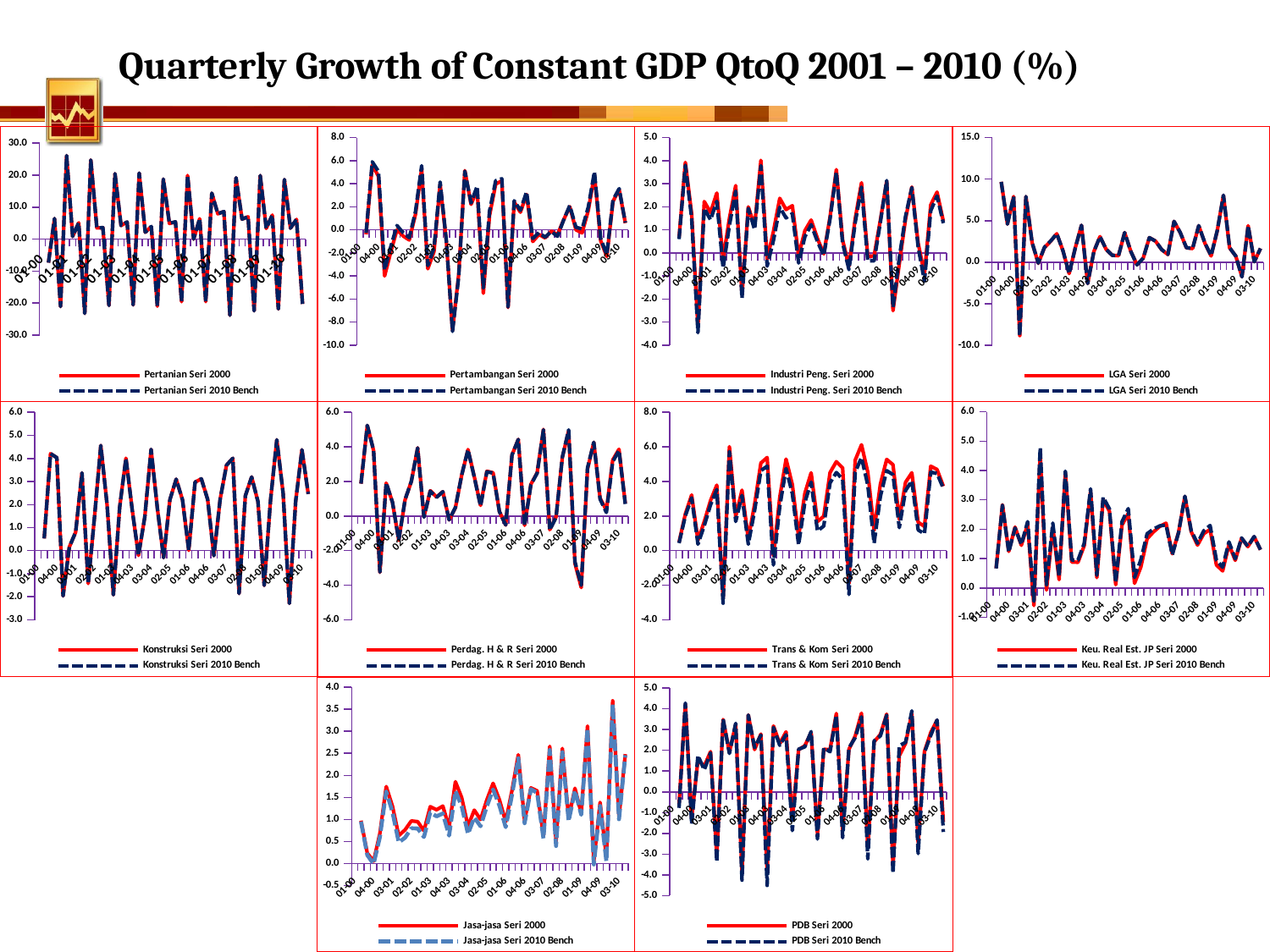
On the Konstruksi chart, is the highest plotted value greater or less than 4.0? greater On the Jasa-jasa chart, is the highest plotted value greater or less than 3.0? greater How many series does the legend of the Pertambangan chart list? 2 On the Pertanian chart, is the highest plotted value greater or less than 20.0? greater How many charts are shown on the slide? 10 What kind of chart is the Pertanian chart (top-left)? Line chart What are the two legend entries of the PDB chart (bottom-right)? PDB Seri 2000 and PDB Seri 2010 Bench How many series does the legend of the Jasa-jasa chart list? 2